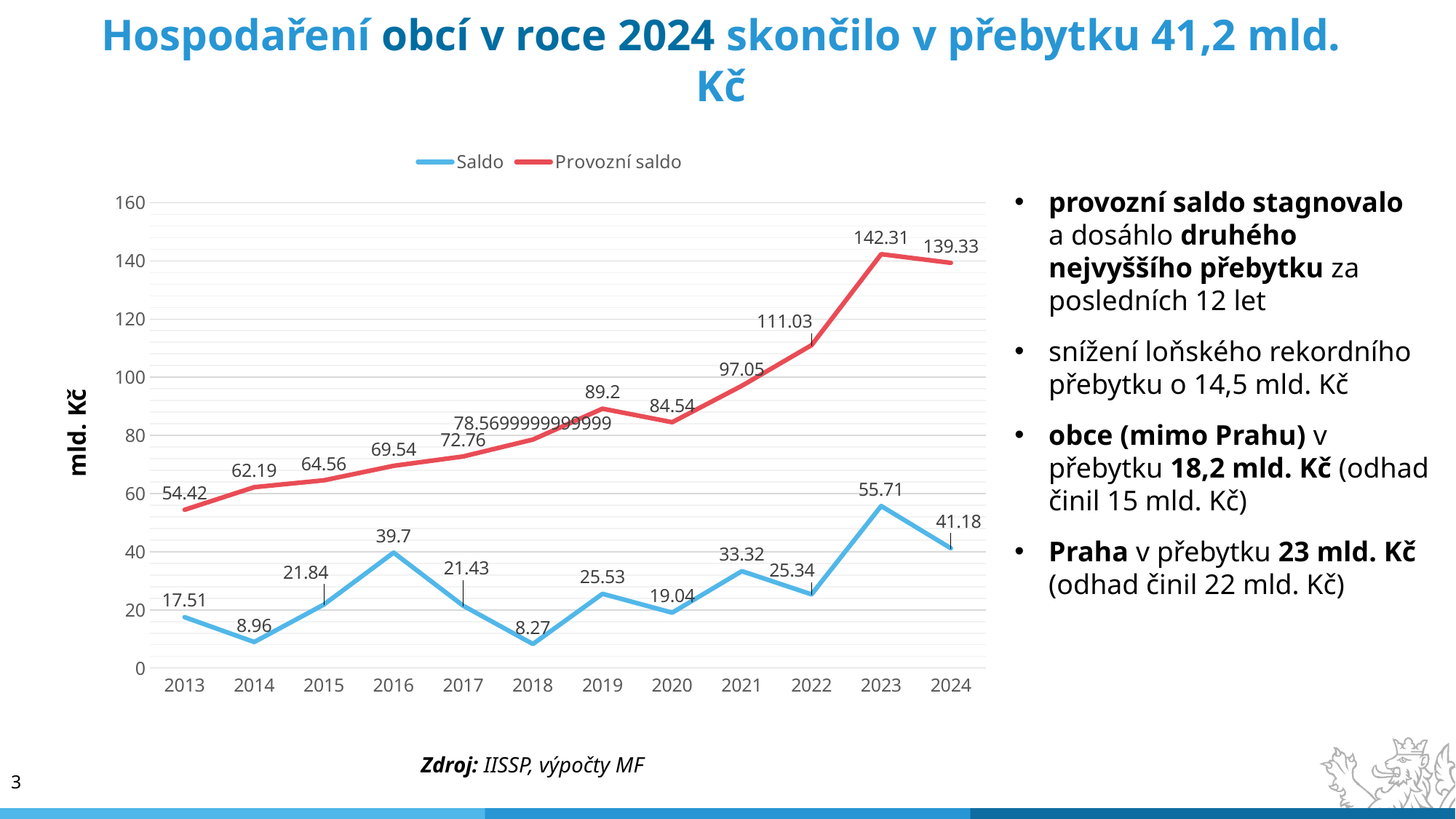
In which year is Provozní saldo highest? 2023 What is the value of Provozní saldo in 2023? 142.31 What is the label on the vertical axis? mld. Kč Is the value of Provozní saldo in 2022 greater or less than 100? greater Which is larger: Saldo in 2016 or Saldo in 2021? Saldo in 2016 What is the value of Saldo in 2024? 41.18 How many years are plotted on the x axis? 12 What type of chart is shown on the slide? line chart In which year is Saldo lowest? 2018 How many series does the legend list? 2 What is the value of Saldo in 2018? 8.27 What is the difference between Provozní saldo in 2023 and in 2024? 2.98